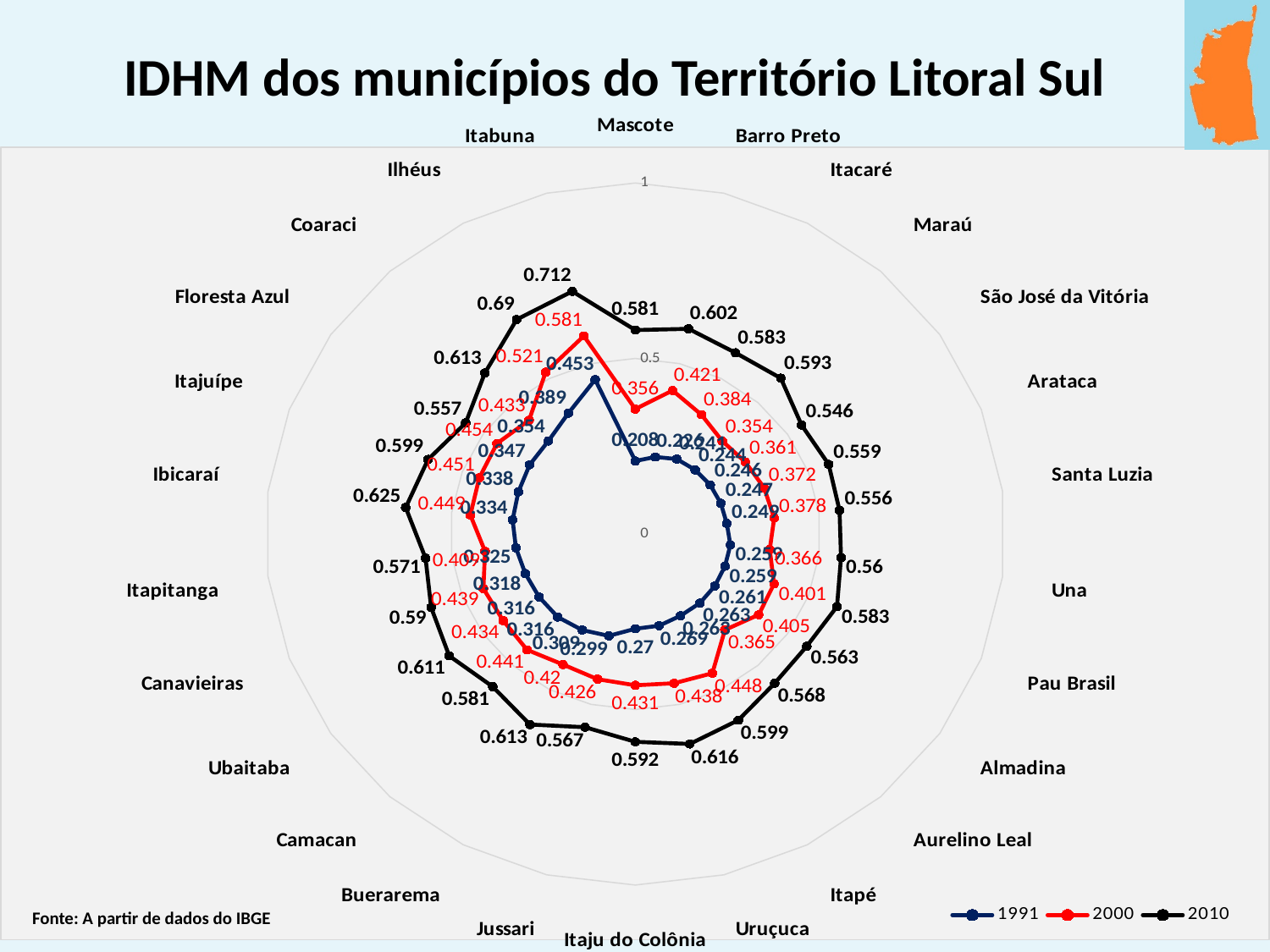
What is the difference between Itabuna's 2010 and 2000 IDHM values? 0.131 What is the 2000 IDHM value for Ilhéus? 0.521 In the 2010 series, which is larger: Ibicaraí or Uruçuca? Ibicaraí Which municipality has the highest IDHM in the 2000 series? Itabuna What is the 2010 IDHM value for Itabuna? 0.712 How many municipalities are plotted on the chart? 26 Which municipality has the lowest IDHM in the 2010 series? São José da Vitória Which years are listed in the legend? 1991, 2000, 2010 How many series does the legend list? 3 What is the 2010 IDHM value for Canavieiras? 0.59 What kind of chart is shown on the slide? Radar chart Which municipality has the highest IDHM in the 2010 series? Itabuna